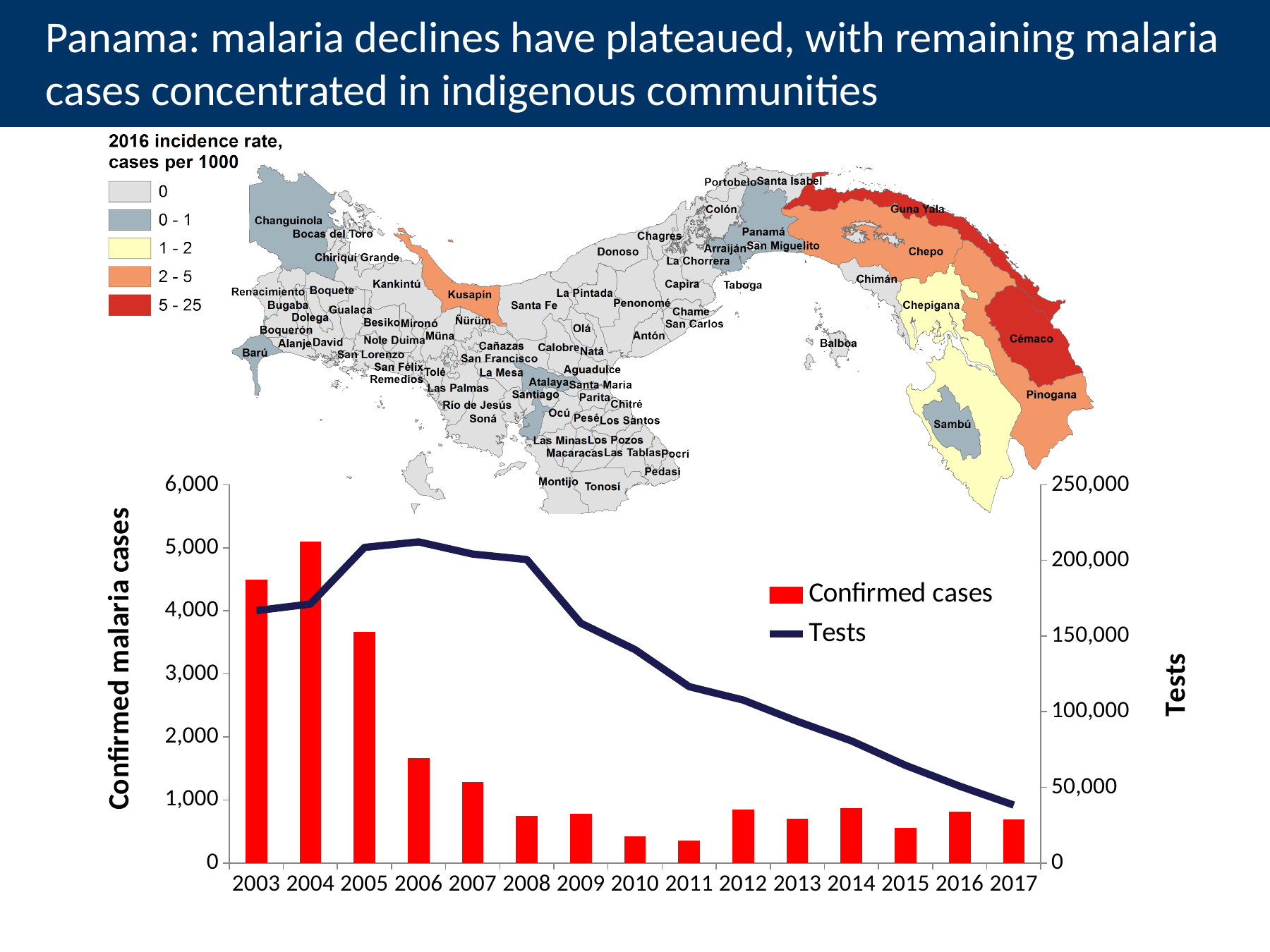
In which year was the number of tests lowest? 2017 Is the number of confirmed cases in 2010 greater or less than 1,000? less Is the number of tests in 2017 greater or less than 50,000? less Which year had more confirmed cases, 2005 or 2006? 2005 How many series does the legend of the bottom chart list? 2 In which year were confirmed malaria cases highest? 2004 How many years are shown on the x axis of the bottom chart? 15 Is the number of confirmed cases in 2003 greater or less than 4,000? greater What kind of chart is shown at the bottom of the slide? A bar chart combined with a line chart In which year were confirmed malaria cases lowest? 2011 What are the two entries in the legend of the bottom chart? Confirmed cases and Tests Do the number of tests rise or fall from 2008 to 2017? fall